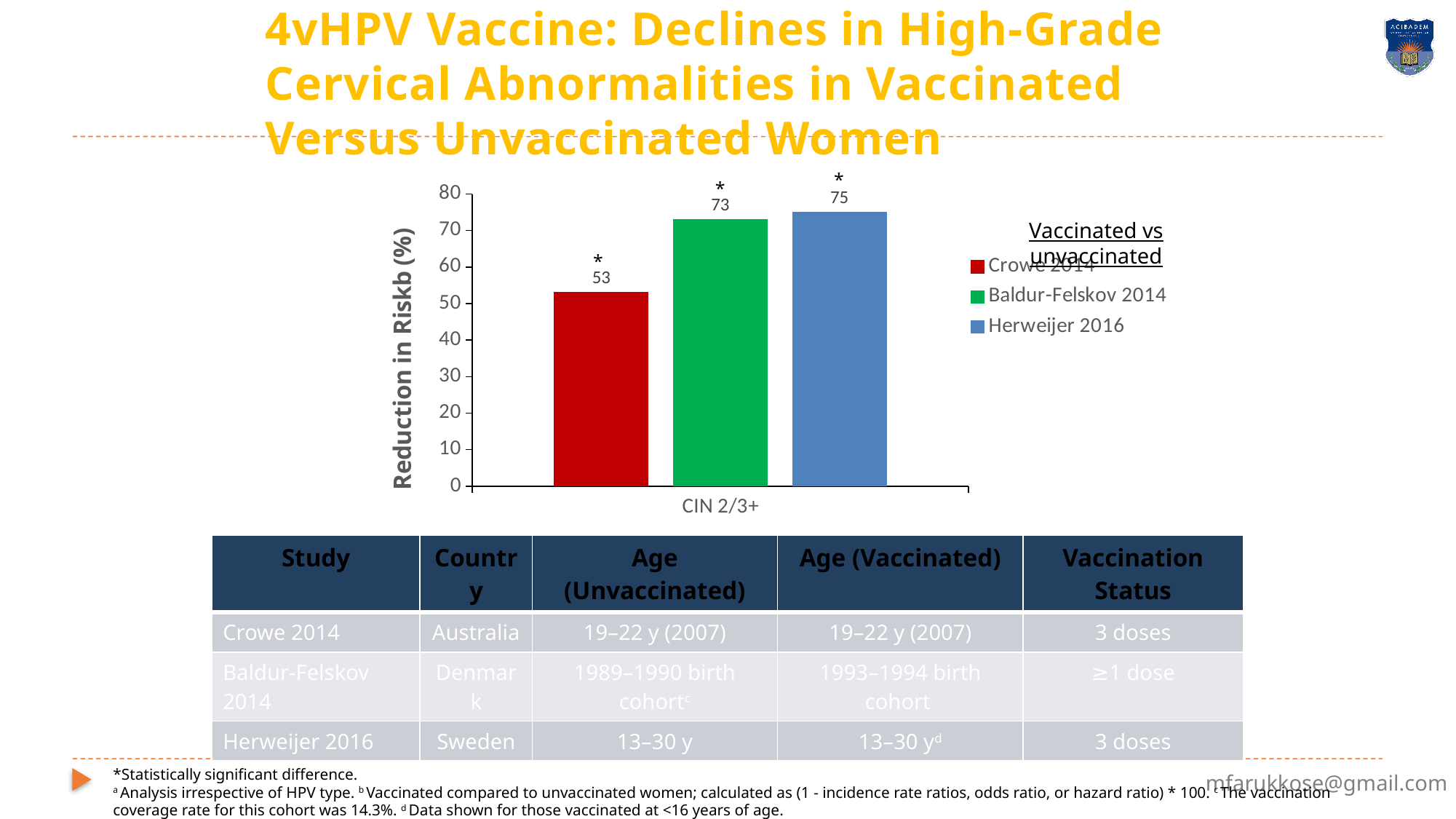
Which has a larger reduction in risk, Crowe 2014 or Baldur-Felskov 2014? Baldur-Felskov 2014 What kind of chart is shown on the slide? Bar chart Is the value for Crowe 2014 greater or less than 60? less What is the label on the y axis of the chart? Reduction in Riskb (%) What is the reduction in risk for Baldur-Felskov 2014? 73 What is the reduction in risk for Herweijer 2016? 75 Which study shows the lowest reduction in risk? Crowe 2014 What is the difference in reduction in risk between Herweijer 2016 and Crowe 2014? 22 What is the difference in reduction in risk between Baldur-Felskov 2014 and Crowe 2014? 20 How many series does the legend list? 3 Which study shows the highest reduction in risk? Herweijer 2016 What is the reduction in risk for Crowe 2014 in the CIN 2/3+ chart? 53